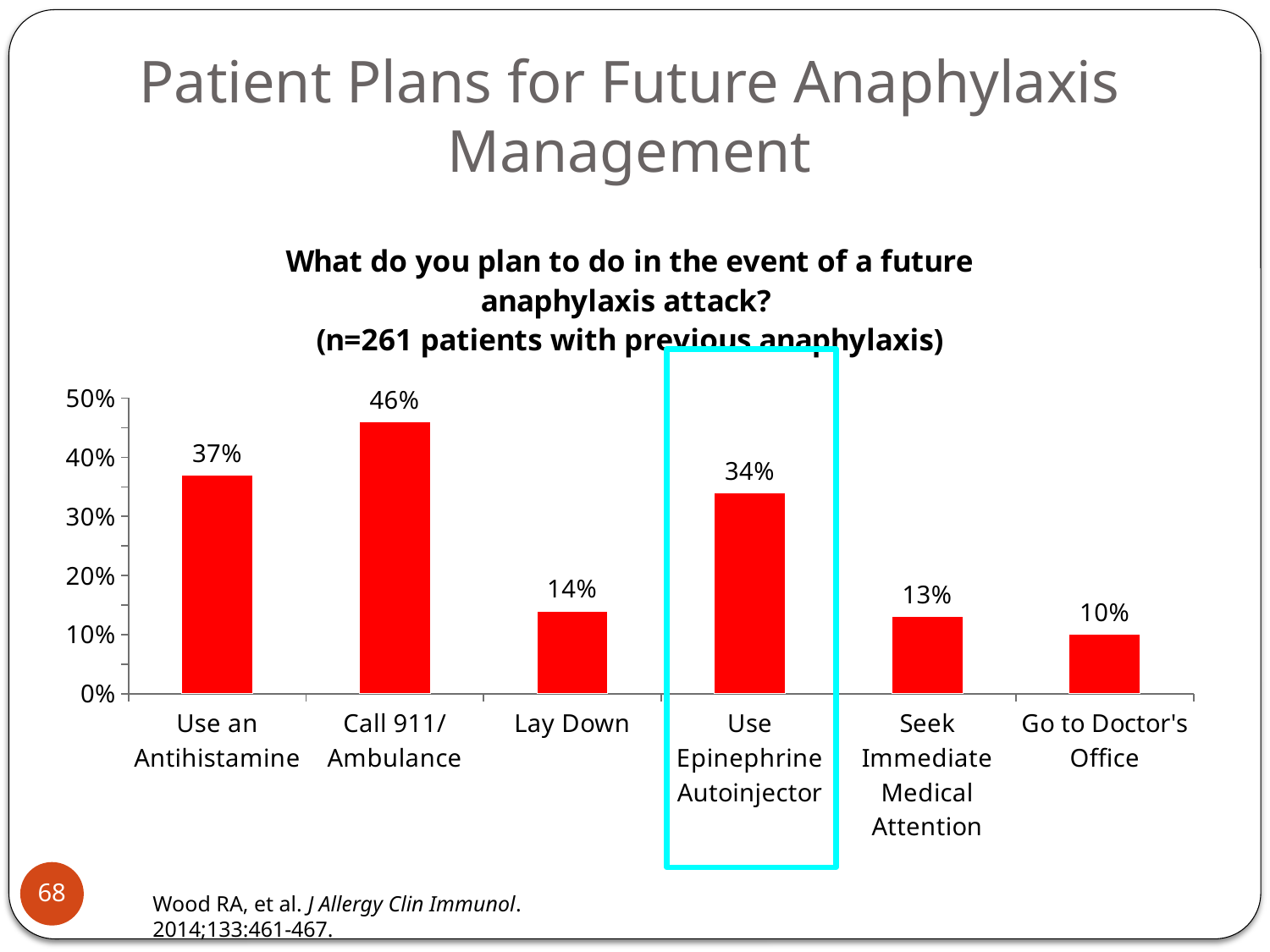
Is the value for Use an Antihistamine greater or less than 30%? greater Which planned action has the highest percentage of patients? Call 911/ Ambulance How many patients with previous anaphylaxis were surveyed, according to the chart title? 261 What is the value shown for Use Epinephrine Autoinjector? 34% Which bar is highlighted with a cyan rectangle? Use Epinephrine Autoinjector What kind of chart is shown on the slide? bar chart What percentage of patients plan to go to the doctor's office? 10% How many planned actions (categories) are shown on the chart? 6 What is the difference in percentage points between Call 911/ Ambulance and Use Epinephrine Autoinjector? 12 What percentage of patients plan to use an antihistamine in the event of a future anaphylaxis attack? 37% Which planned action has the lowest percentage of patients? Go to Doctor's Office Which is larger, the value for Lay Down or the value for Seek Immediate Medical Attention? Lay Down